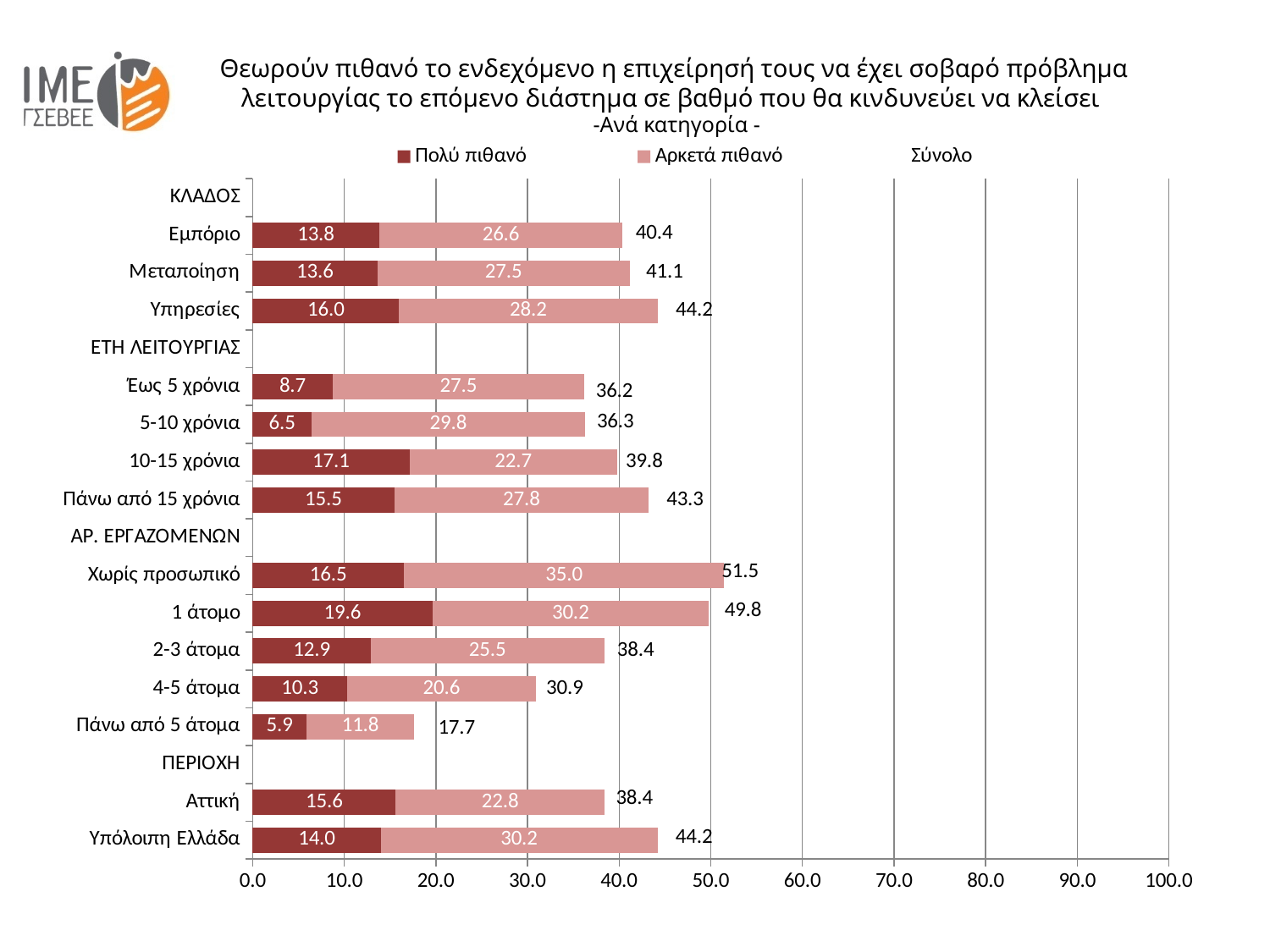
What is the "Αρκετά πιθανό" value for Χωρίς προσωπικό? 35.0 What type of chart is shown on the slide? Stacked bar chart Which category has the lowest total (Σύνολο)? Πάνω από 5 άτομα How many categories have bars plotted in the chart? 14 What is the "Πολύ πιθανό" value for Υπηρεσίες? 16.0 What is the difference between the totals for Υπόλοιπη Ελλάδα and Αττική? 5.8 Which category has the highest total (Σύνολο)? Χωρίς προσωπικό Which category has the highest "Πολύ πιθανό" value? 1 άτομο How many series does the legend list? 3 What is the total (Σύνολο) for 1 άτομο? 49.8 Which has a larger "Αρκετά πιθανό" value, 5-10 χρόνια or 10-15 χρόνια? 5-10 χρόνια Is the total for Χωρίς προσωπικό greater or less than 50.0? greater